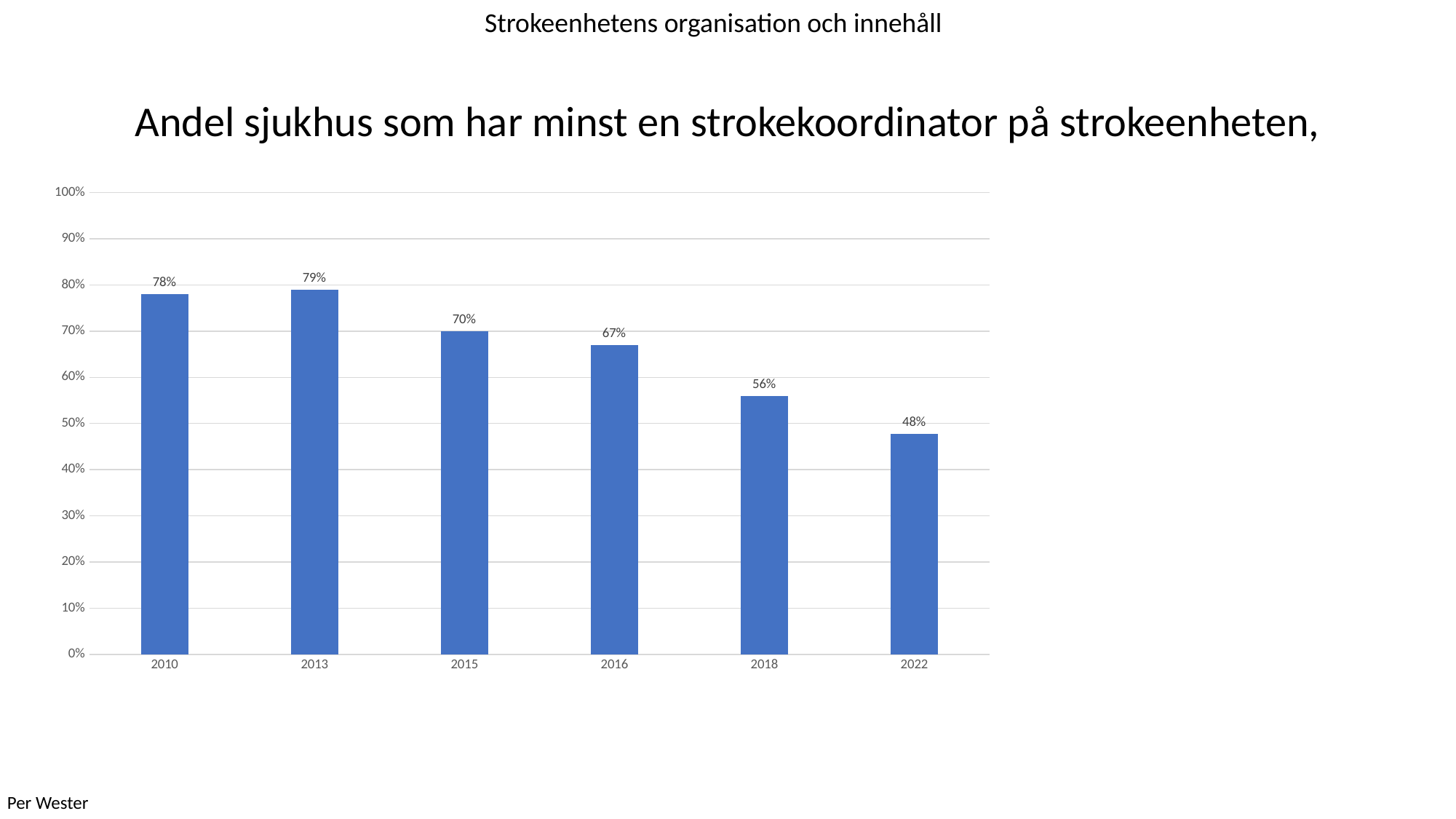
What is the value for 2016? 67% What is the value for 2022? 48% What is the difference between the values for 2013 and 2022? 31% Which is larger, the value for 2015 or the value for 2018? 2015 Which year has the lowest value? 2022 How many years are shown on the x axis? 6 What is the difference between the values for 2015 and 2018? 14% What kind of chart is shown on the slide? bar chart Is the value for 2018 greater or less than 60%? less Which year has the highest value? 2013 Do the values generally rise or fall from 2013 to 2022? fall What is the value for 2010? 78%